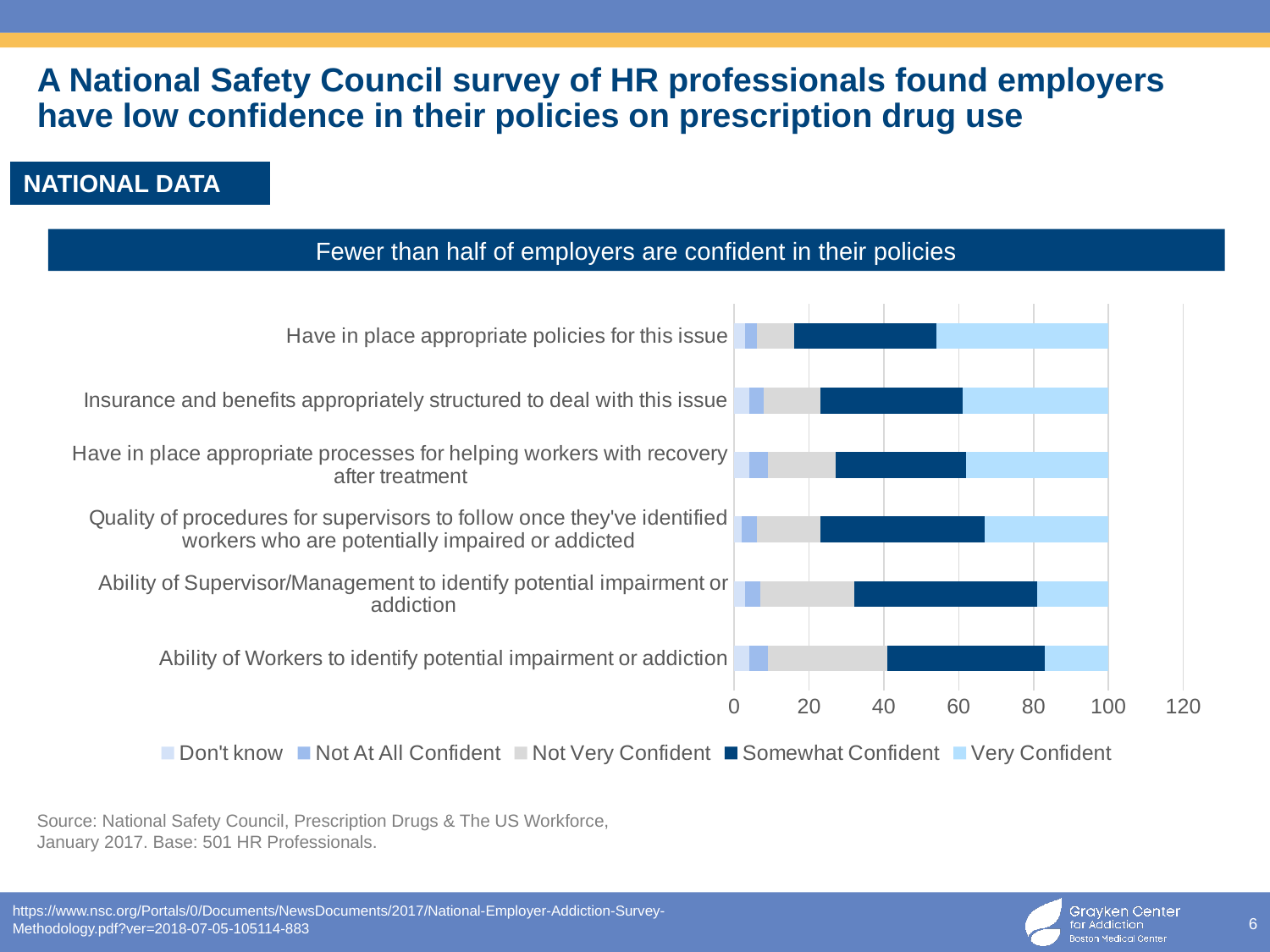
Which category has the largest 'Very Confident' segment? Have in place appropriate policies for this issue What is the title shown above the chart? Fewer than half of employers are confident in their policies What is the highest value shown on the horizontal axis? 120 What kind of chart is shown on the slide? Stacked bar chart Is the 'Not Very Confident' segment for 'Ability of Workers to identify potential impairment or addiction' greater or less than 20? greater Is the 'Very Confident' segment for 'Have in place appropriate policies for this issue' greater or less than 40? greater How many categories (survey items) are plotted on the chart? 6 Is the 'Somewhat Confident' segment for 'Ability of Supervisor/Management to identify potential impairment or addiction' greater or less than 40? greater How many series does the chart legend list? 5 Which has the larger 'Very Confident' segment: 'Have in place appropriate policies for this issue' or 'Ability of Workers to identify potential impairment or addiction'? Have in place appropriate policies for this issue Which series is listed first in the chart legend? Don't know